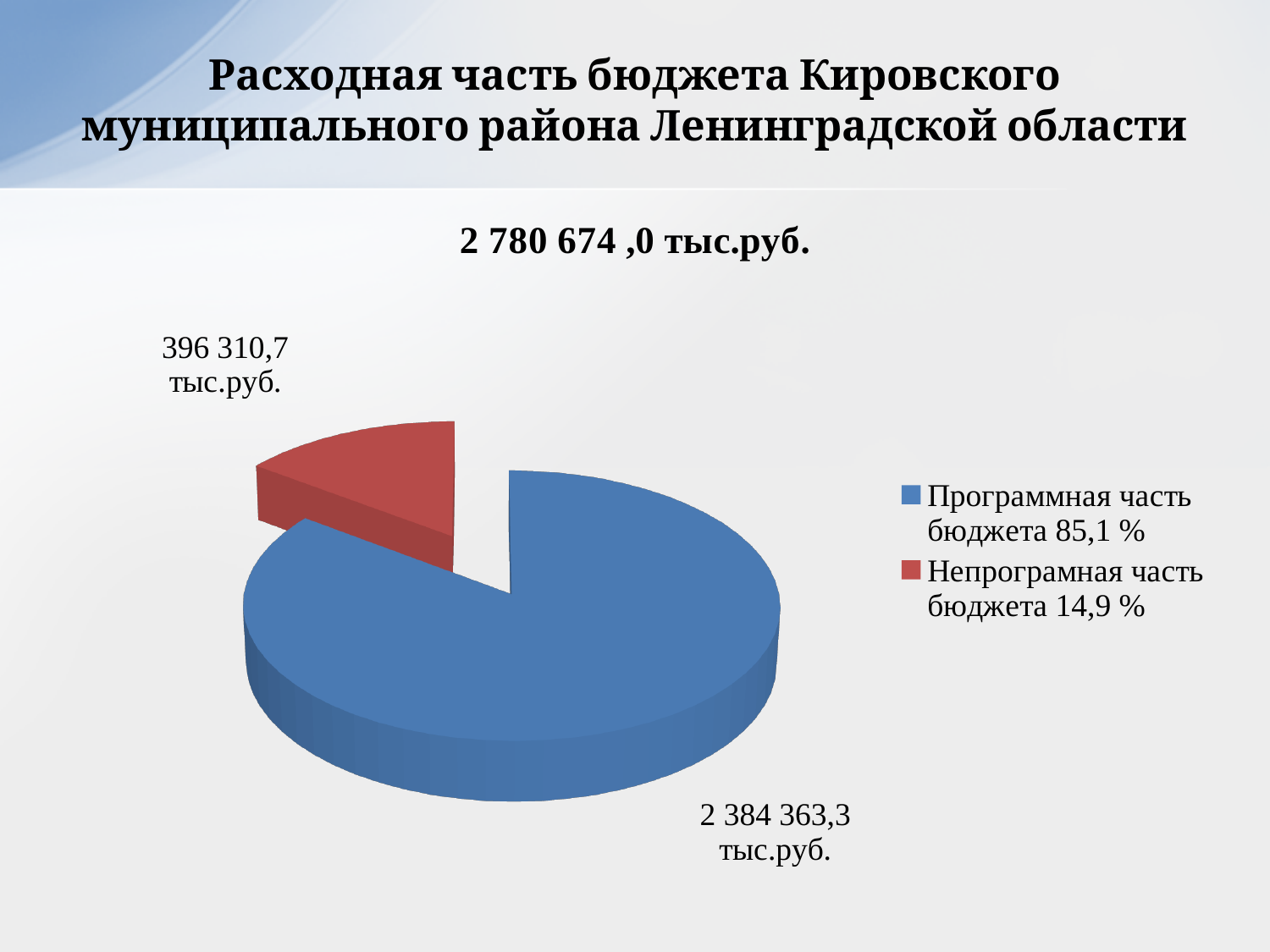
What share of the pie does Непрограмная часть бюджета represent, according to the legend? 14,9 % How many slices does the pie chart have? 2 What colour is the Непрограмная часть бюджета slice? Red What kind of chart is shown on the slide? Pie chart What is the value shown for the Программная часть бюджета slice? 2 384 363,3 тыс.руб. What share of the pie does Программная часть бюджета represent, according to the legend? 85,1 % Which slice of the pie is the smallest? Непрограмная часть бюджета Which slice of the pie is the largest? Программная часть бюджета What total value is shown above the pie chart? 2 780 674 ,0 тыс.руб. How many entries does the legend list? 2 What is the value shown for the Непрограмная часть бюджета slice? 396 310,7 тыс.руб. Which is larger: Программная часть бюджета or Непрограмная часть бюджета? Программная часть бюджета